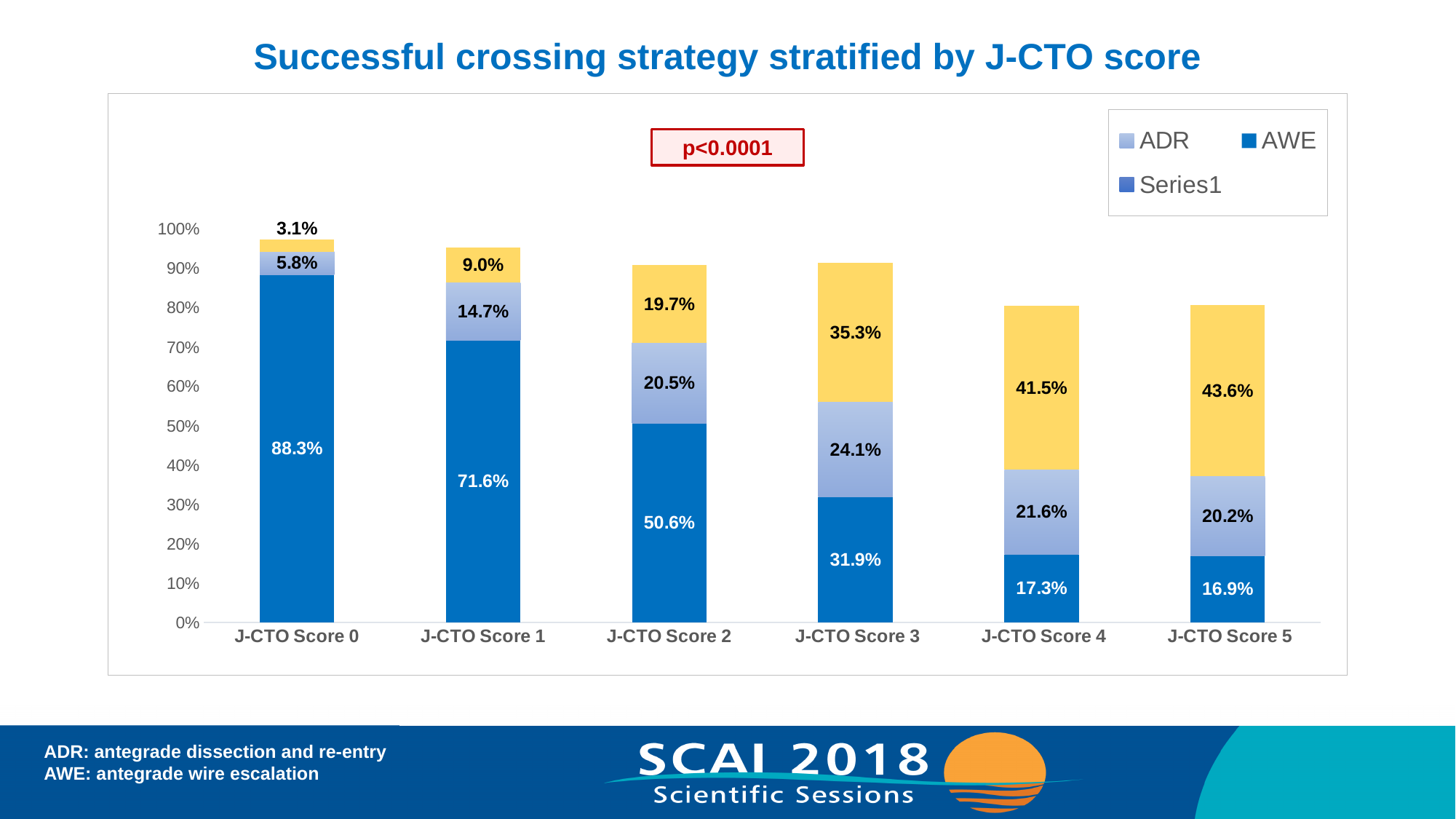
How many series does the legend list? 3 What kind of chart is shown on the slide? Stacked bar chart Which is larger, the ADR value for J-CTO Score 2 or for J-CTO Score 4? J-CTO Score 4 What is the AWE value for J-CTO Score 0? 88.3% Which J-CTO score category has the highest ADR value? J-CTO Score 3 What is the value of the top (yellow) segment for J-CTO Score 5? 43.6% Does the AWE value rise or fall as the J-CTO score increases from 0 to 5? Falls What is the difference between the AWE values for J-CTO Score 0 and J-CTO Score 1? 16.7 percentage points Which J-CTO score category has the highest AWE value? J-CTO Score 0 Which J-CTO score category has the lowest AWE value? J-CTO Score 5 How many J-CTO score categories are shown on the x axis? 6 What is the ADR value for J-CTO Score 3? 24.1%